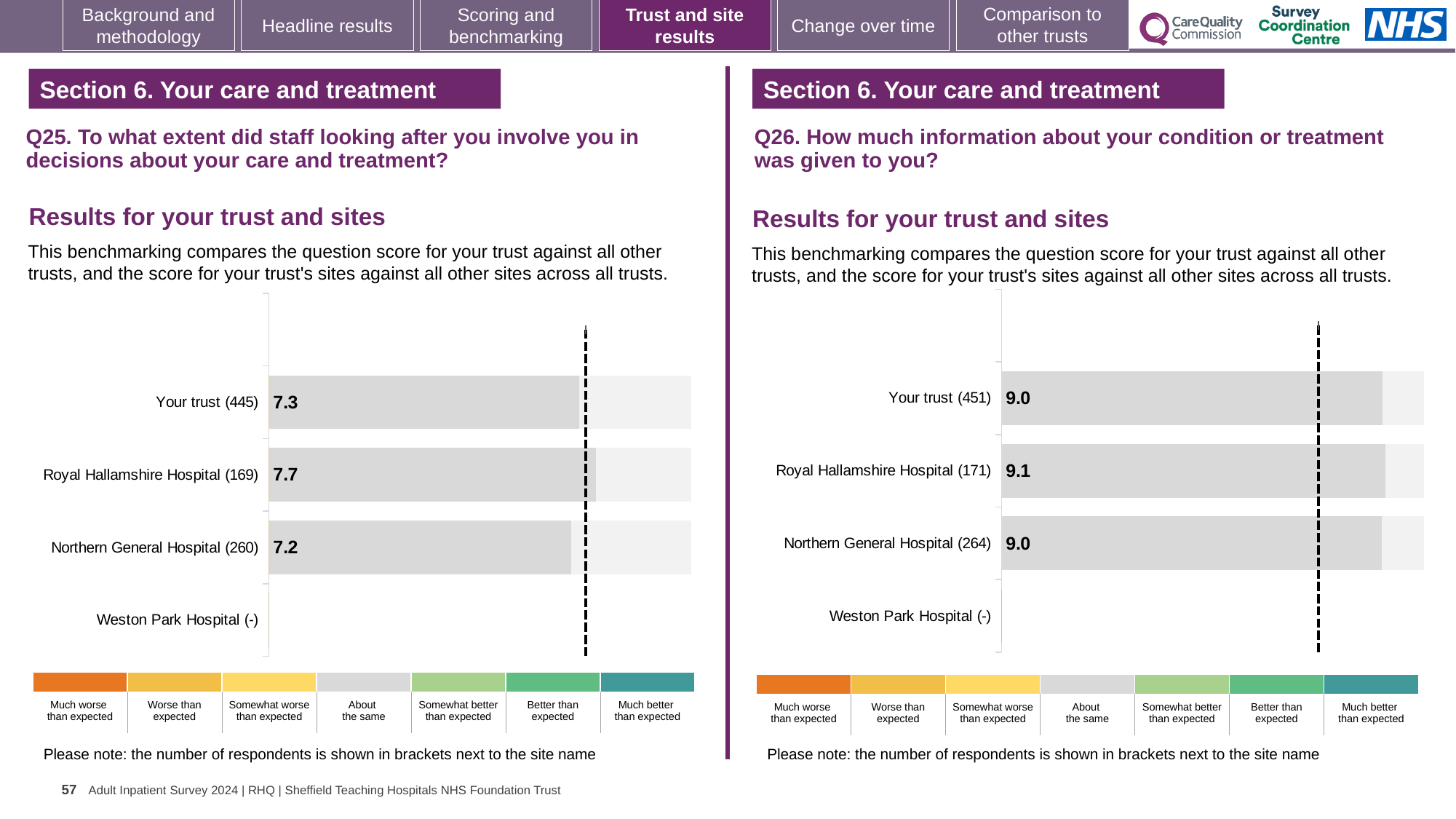
What kind of chart is used in the Q26 chart on the right? Bar chart In the Q25 chart on the left, how many respondents are shown in brackets for Northern General Hospital? 260 In the Q25 chart on the left, which site has the highest score? Royal Hallamshire Hospital In the Q26 chart on the right, what is the score for Northern General Hospital? 9.0 In the Q26 chart on the right, how many sites or categories are listed on the vertical axis? 4 In the Q25 chart on the left, what is the score for Your trust? 7.3 In the Q26 chart on the right, what is the score for Royal Hallamshire Hospital? 9.1 In the Q26 chart on the right, what is the difference between the scores for Royal Hallamshire Hospital and Your trust? 0.1 In the Q26 chart on the right, what is the score for Your trust? 9.0 In the Q25 chart on the left, what is the score for Royal Hallamshire Hospital? 7.7 In the Q25 chart on the left, what is the score for Northern General Hospital? 7.2 In the Q25 chart on the left, what is the difference between the scores for Royal Hallamshire Hospital and Northern General Hospital? 0.5